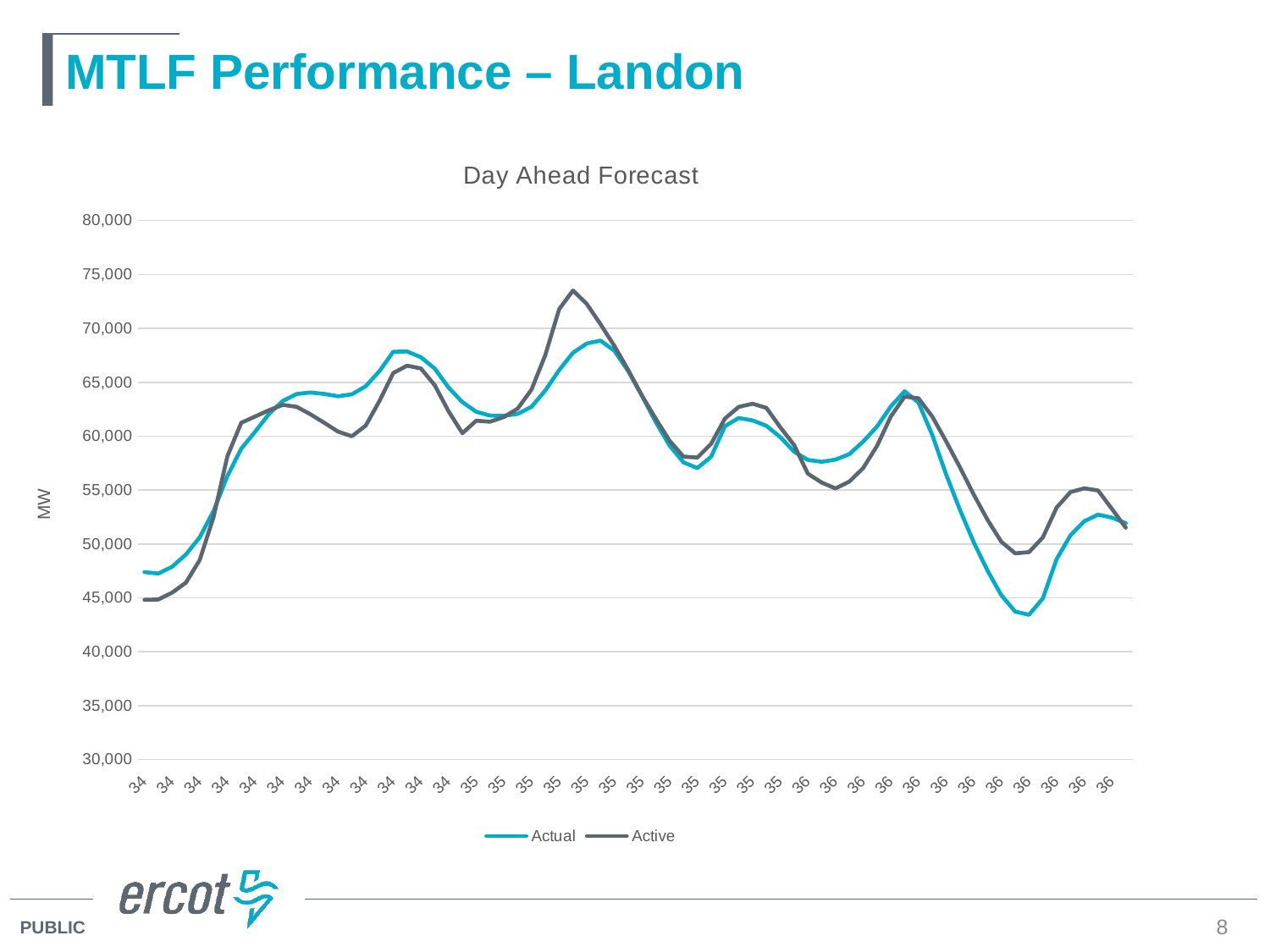
Is the lowest value reached by the Actual series greater or less than 45,000? less Is the highest value reached by the Active series greater or less than 70,000? greater Is the highest value reached by the Actual series greater or less than 70,000? less What are the names of the two series in the legend? Actual and Active What unit is shown on the vertical axis label? MW What kind of chart is shown on the slide? line chart How many series does the legend list? 2 Do the values of both series rise or fall over the first several points of the chart? rise Which series reaches the higher peak, Actual or Active? Active Which series drops to the lower minimum, Actual or Active? Actual